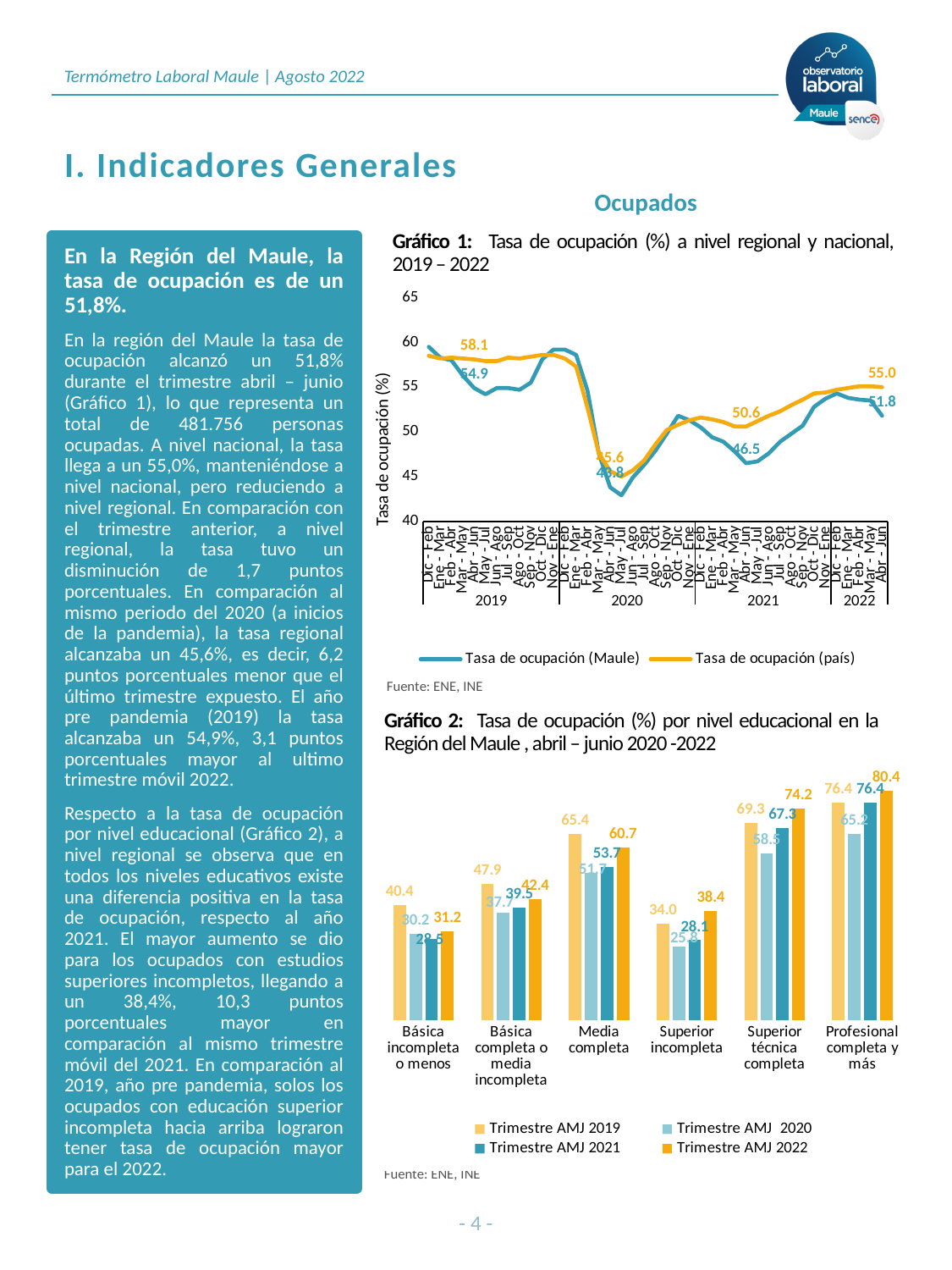
In Gráfico 2, which educational level has the highest value in Trimestre AMJ 2022? Profesional completa y más In Gráfico 2, which is larger for Superior técnica completa: Trimestre AMJ 2019 or Trimestre AMJ 2021? Trimestre AMJ 2019 In Gráfico 2, what is the value for Media completa in Trimestre AMJ 2019? 65.4 What kind of chart is Gráfico 1? line chart In Gráfico 1, what is the most recent value shown for Tasa de ocupación (Maule)? 51.8 In Gráfico 1, how many series does the legend list? 2 In Gráfico 2, which educational level has the lowest value in Trimestre AMJ 2020? Superior incompleta In Gráfico 1, what is the most recent value shown for Tasa de ocupación (país)? 55.0 In Gráfico 2, what is the value for Superior incompleta in Trimestre AMJ 2022? 38.4 In Gráfico 2, how many educational level categories are shown? 6 In Gráfico 1, what is the difference between the latest national value (55.0) and the latest Maule value (51.8)? 3.2 In Gráfico 2, what is the difference between Superior incompleta in Trimestre AMJ 2022 (38.4) and Trimestre AMJ 2021 (28.1)? 10.3